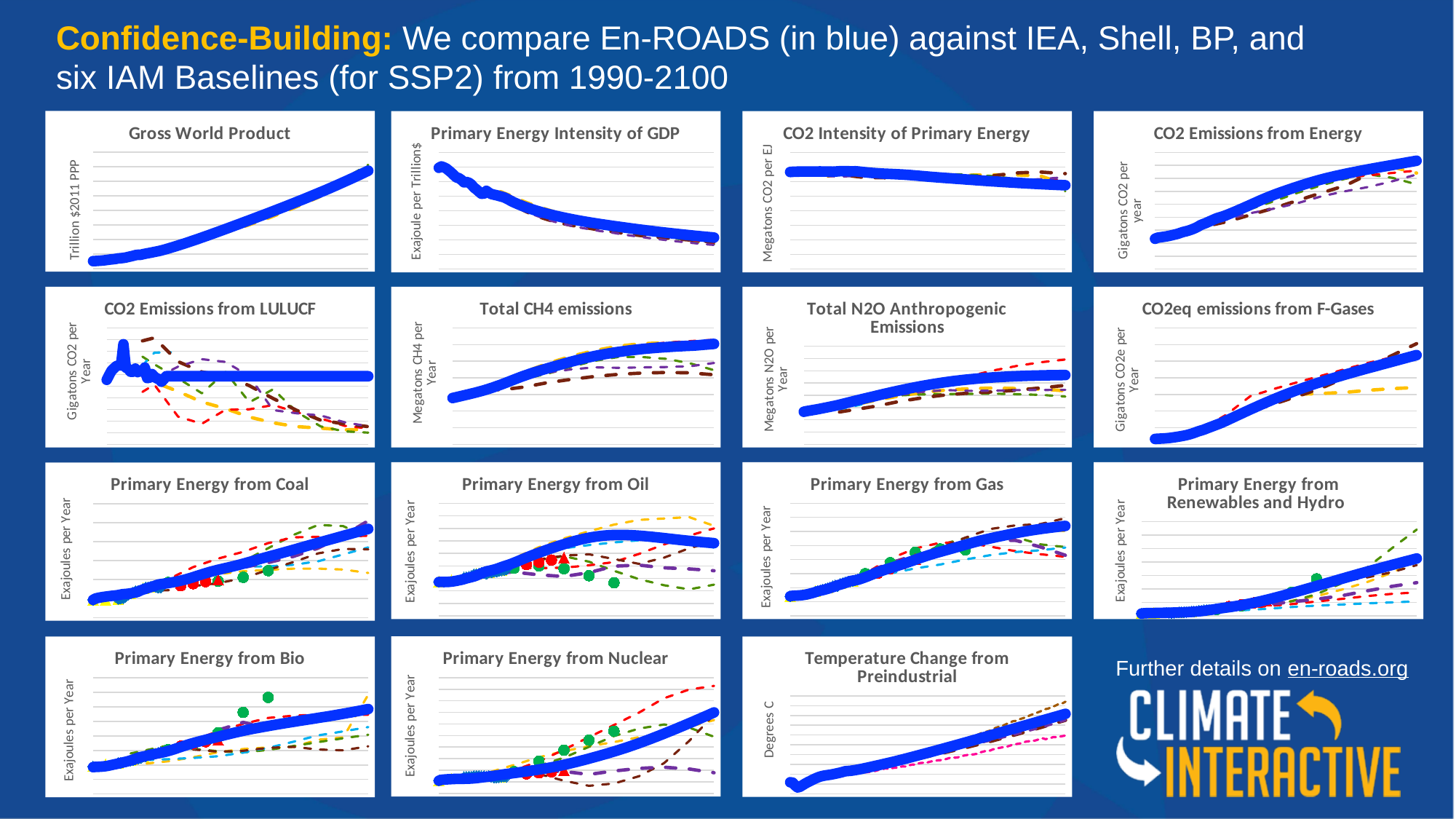
In the "Total CH4 emissions" chart, does the blue En-ROADS line rise or fall from left to right? rise In the "Temperature Change from Preindustrial" chart, does the blue En-ROADS line rise or fall from left to right? rise In the "CO2eq emissions from F-Gases" chart, does the blue En-ROADS line rise or fall from left to right? rise What is the y-axis label of the "Temperature Change from Preindustrial" chart? Degrees C What is the y-axis label of the "Gross World Product" chart? Trillion $2011 PPP What kind of chart is the "Gross World Product" chart? line chart